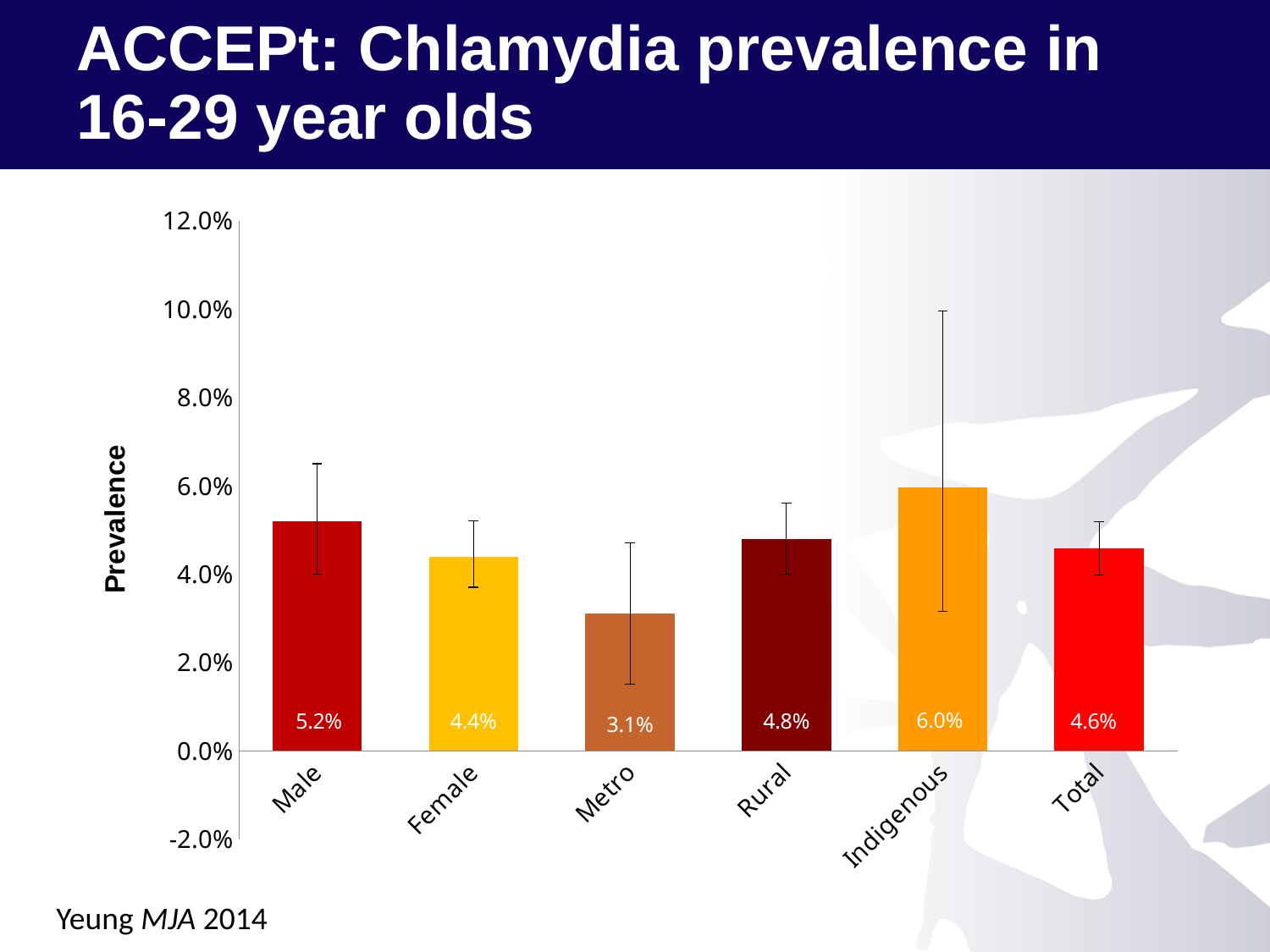
What is the chlamydia prevalence for Metro? 3.1% Which category has the highest prevalence? Indigenous What is the chlamydia prevalence for Male? 5.2% What is the chlamydia prevalence for Indigenous? 6.0% What is the difference in prevalence between Indigenous and Total? 1.4% What kind of chart is shown on the slide? Bar chart What is the label of the y axis? Prevalence Which has a higher prevalence, Rural or Metro? Rural Is the value for Total greater or less than 4.0%? greater What is the difference in prevalence between Male and Female? 0.8% Which category has the lowest prevalence? Metro How many categories are shown on the x axis? 6